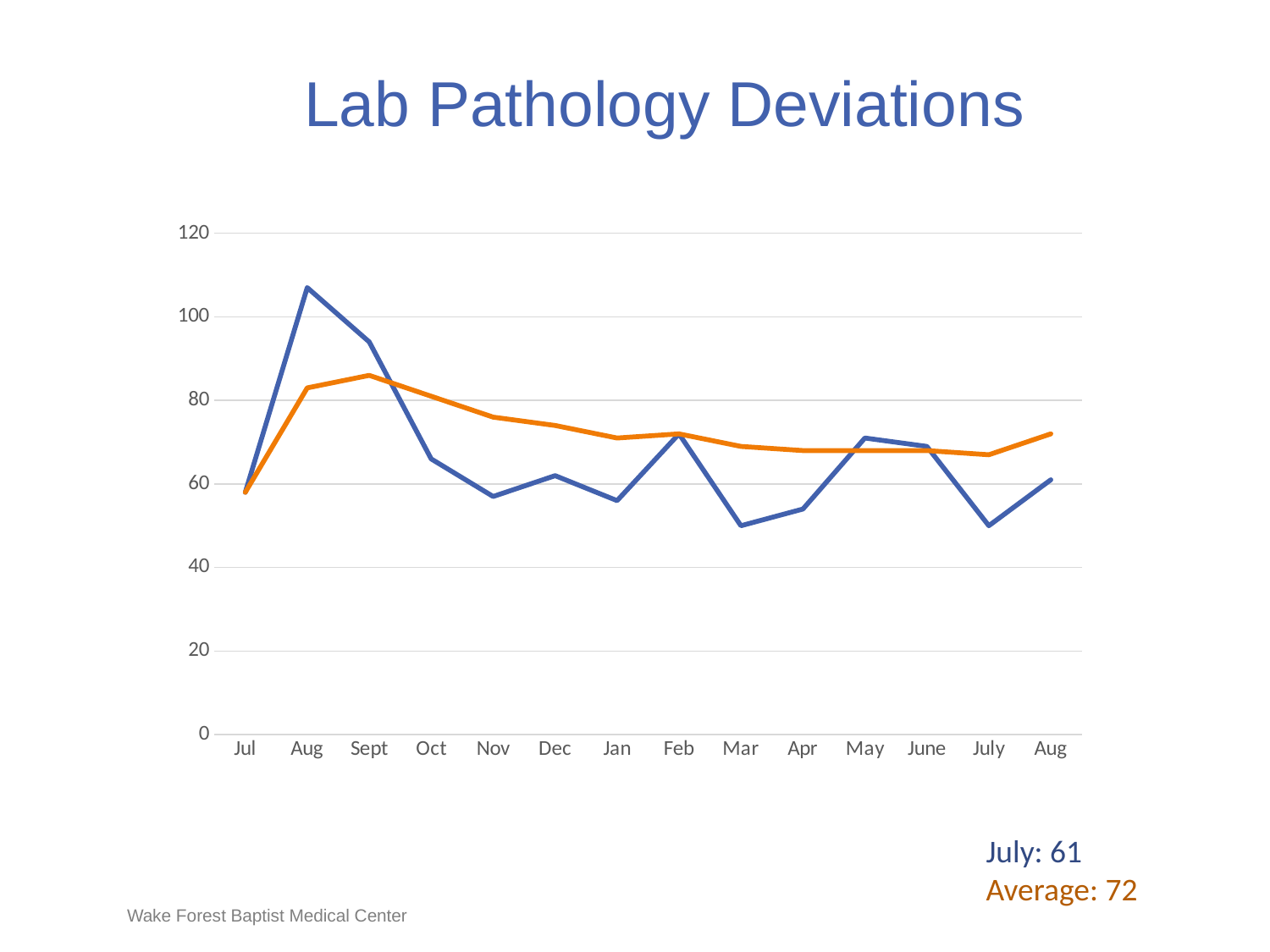
What kind of chart is shown on the slide? line chart Is the blue line's value for Mar greater or less than 60? less What average value is stated in the text below the chart? 72 Is the blue line's value for the first Aug greater or less than 100? greater Is the orange line's value for Sept greater or less than 80? greater How many lines are plotted on the chart? 2 How many months are labelled along the x axis? 14 Does the orange line rise or fall from Sept to July? fall In Oct, which line has the higher value, the blue line or the orange line? the orange line What is the title of the chart? Lab Pathology Deviations In which month does the orange line reach its highest value? Sept In which month does the blue line reach its highest value? Aug (the first Aug)